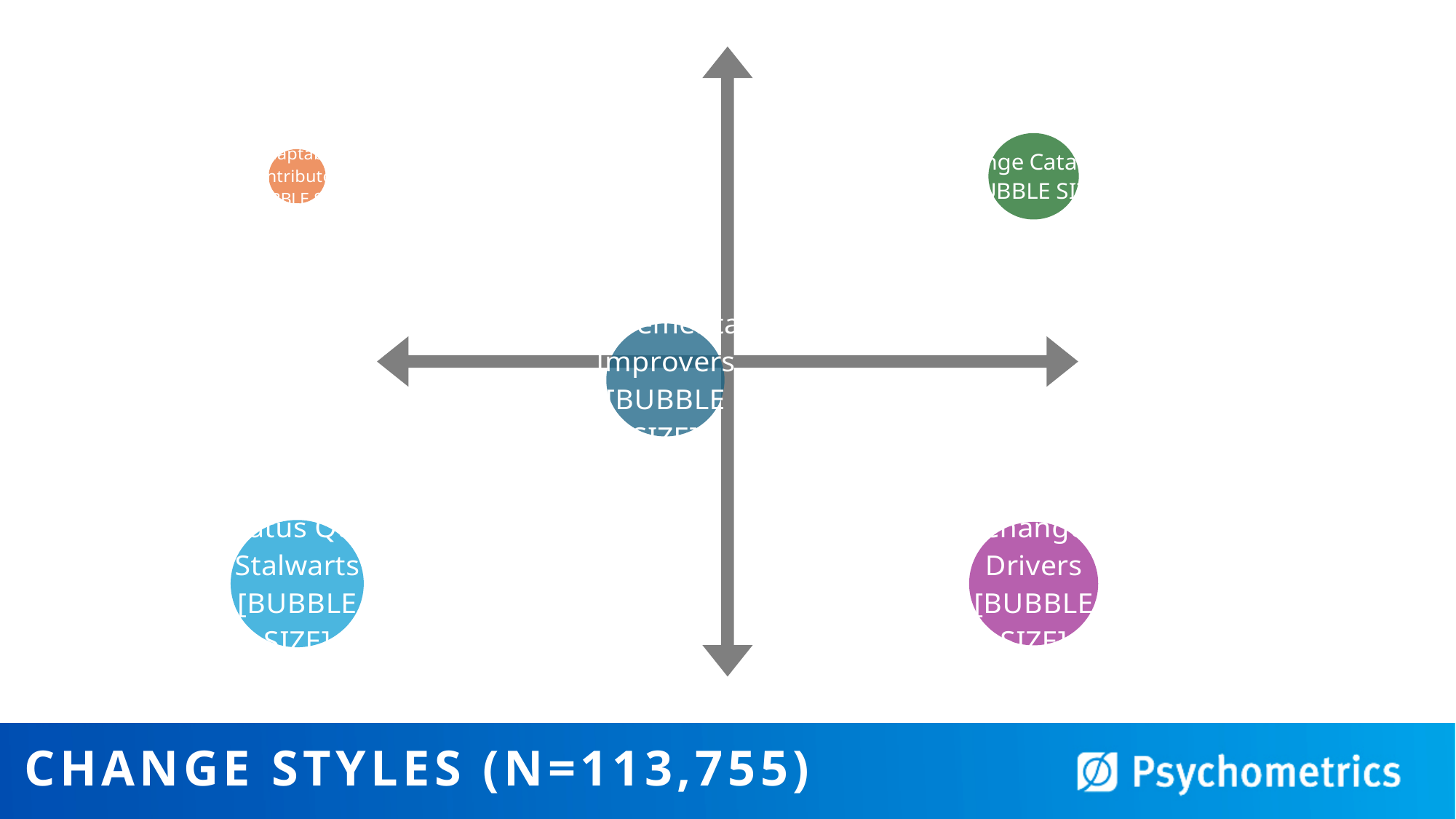
How many bubbles are plotted on the chart? 5 Which bubble on the chart is the smallest? the orange bubble in the top-left What kind of chart is shown on the slide? bubble chart What is the title shown in the banner at the bottom of the slide? CHANGE STYLES (N=113,755) Is the Change Drivers bubble larger or smaller than the green bubble in the top-right? larger Is the Status Quo Stalwarts bubble larger or smaller than the orange bubble in the top-left? larger Which bubble is located in the bottom-right quadrant of the chart? Change Drivers Is the Incremental Improvers bubble larger or smaller than the orange bubble in the top-left? larger